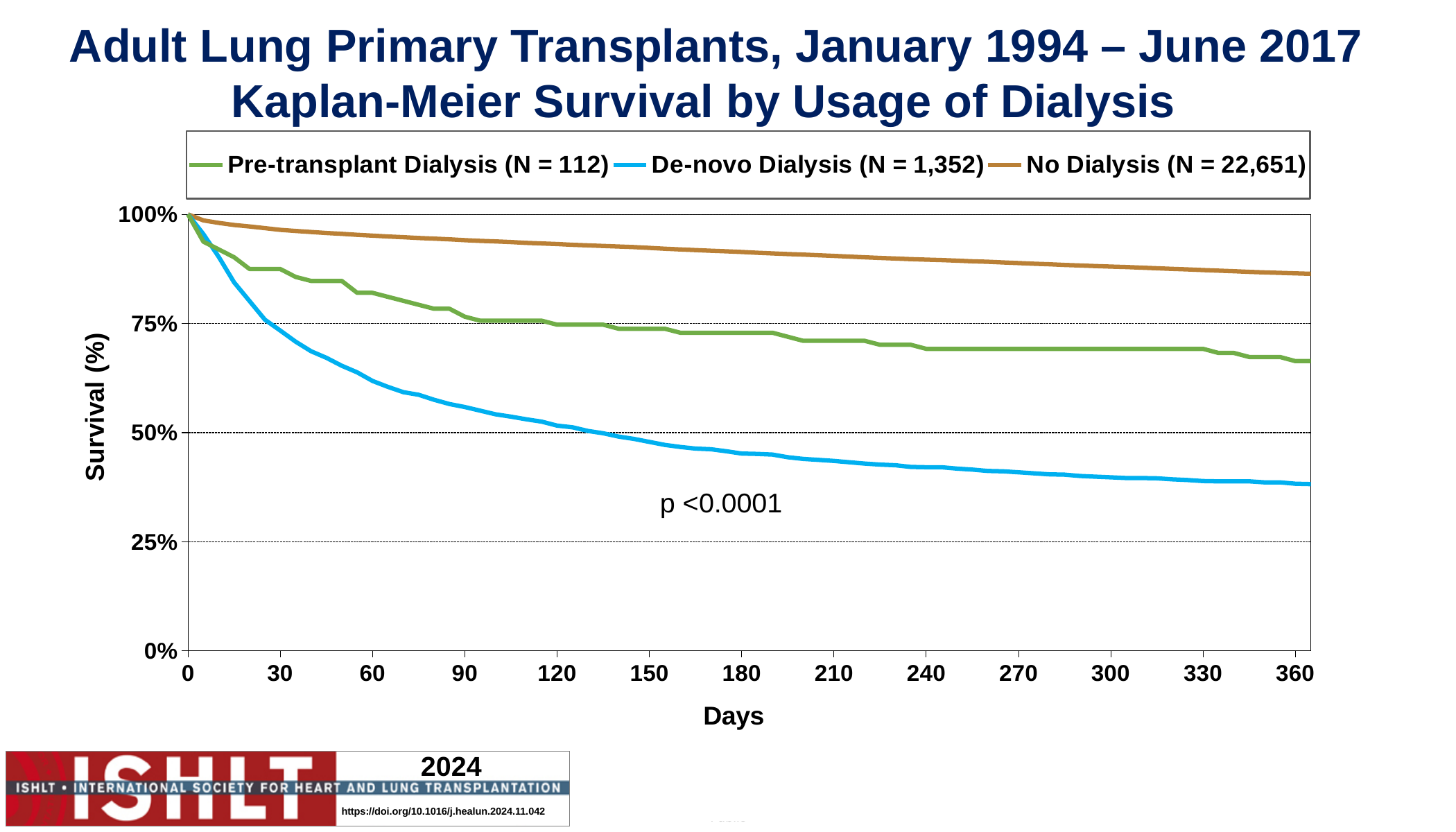
Which series has the highest survival at 360 days? No Dialysis At 360 days, which series has higher survival: Pre-transplant Dialysis or De-novo Dialysis? Pre-transplant Dialysis Is the survival for No Dialysis at 360 days greater or less than 75%? greater Is the survival for De-novo Dialysis at 60 days greater or less than 50%? greater What kind of chart is shown on the slide? line chart What is the N for the De-novo Dialysis group shown in the legend? 1,352 How many series does the legend list? 3 Is the survival for De-novo Dialysis at 360 days greater or less than 50%? less Which series has the lowest survival at 360 days? De-novo Dialysis What is the survival value for all three series at day 0? 100% Do the survival curves rise or fall as the number of days increases? fall